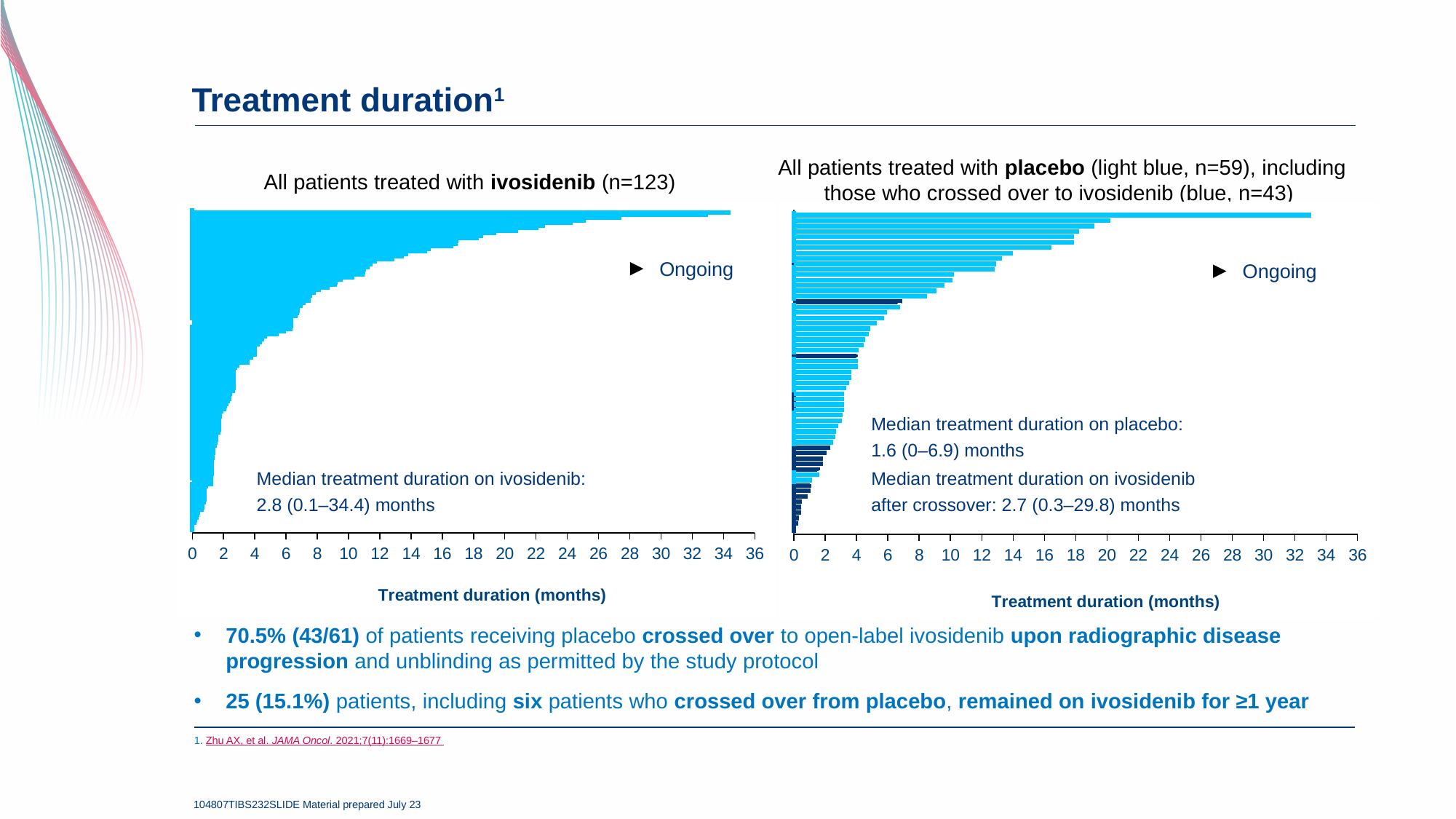
In the right chart, what is the median treatment duration on ivosidenib after crossover? 2.7 (0.3–29.8) months In the right chart, how many placebo patients crossed over to ivosidenib? 43 In the right chart, how many patients were treated with placebo? 59 In the left chart, what is the median treatment duration on ivosidenib? 2.8 (0.1–34.4) months In the left chart, is the longest treatment duration bar greater or less than 30 months? greater In the right chart, is the longest treatment duration bar greater or less than 30 months? greater In the left chart, how many patients were treated with ivosidenib? 123 In the right chart, what is the median treatment duration on placebo? 1.6 (0–6.9) months What kind of chart is used on the left to show treatment duration for patients treated with ivosidenib? Bar chart What is the difference between the median treatment duration on ivosidenib (left chart) and the median treatment duration on placebo (right chart)? 1.2 months Which is larger: the median treatment duration on ivosidenib in the left chart or the median treatment duration on placebo in the right chart? Median treatment duration on ivosidenib (2.8 months) What is the x-axis label of the left chart? Treatment duration (months)